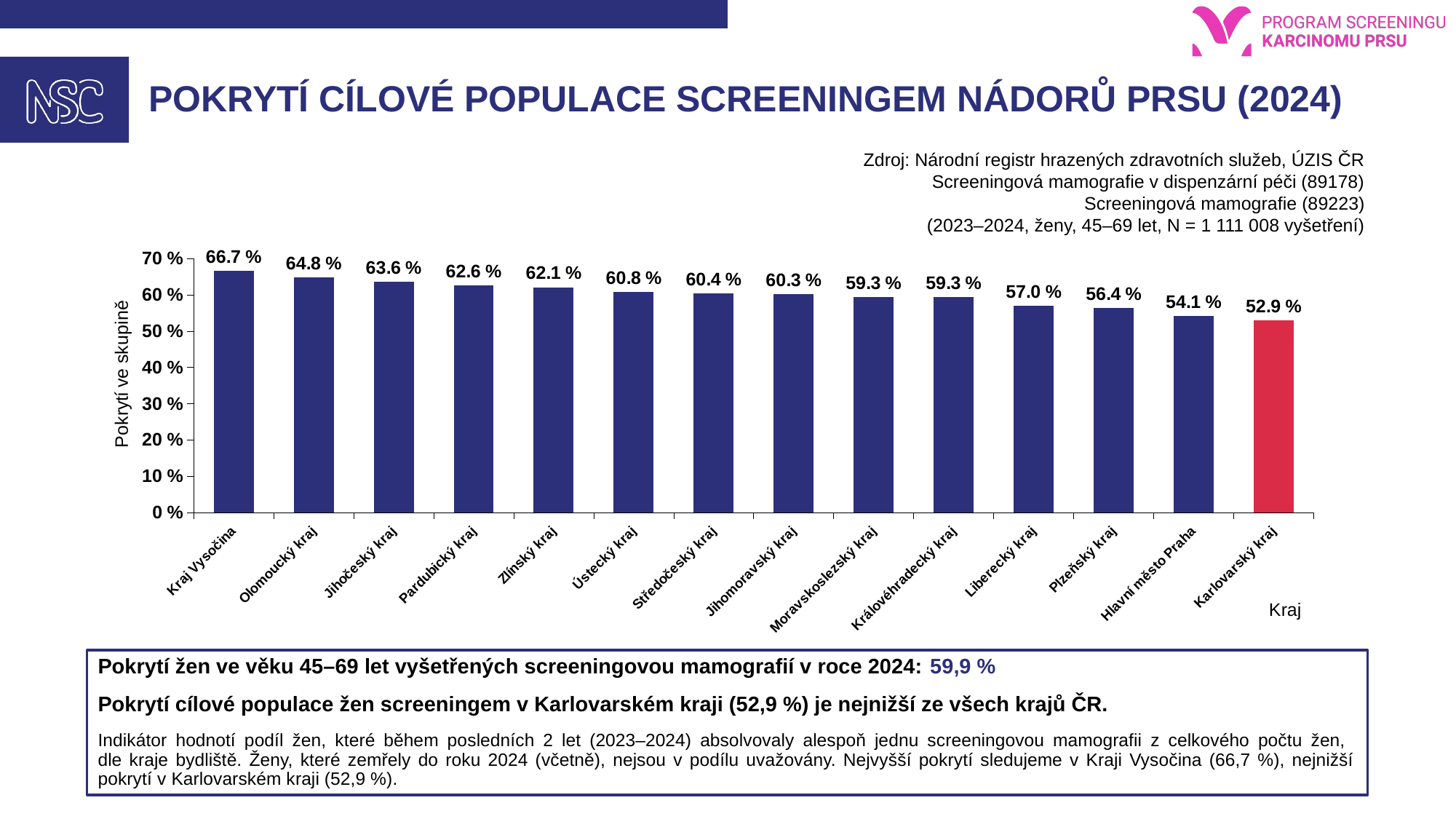
What kind of chart is shown on the slide? bar chart What is the difference between the coverage in Kraj Vysočina and Karlovarský kraj? 13.8 % What is the screening coverage value for Hlavní město Praha? 54.1 % Which region has the highest screening coverage? Kraj Vysočina Which region has the lowest screening coverage? Karlovarský kraj Is the value for Liberecký kraj greater or less than 60 %? less Which has higher coverage, Olomoucký kraj or Plzeňský kraj? Olomoucký kraj How many regions are shown on the chart? 14 What is the screening coverage value for Karlovarský kraj? 52.9 % What is the screening coverage value for Ústecký kraj? 60.8 % What is the screening coverage value for Kraj Vysočina? 66.7 % Which bar is highlighted in red on the chart? Karlovarský kraj